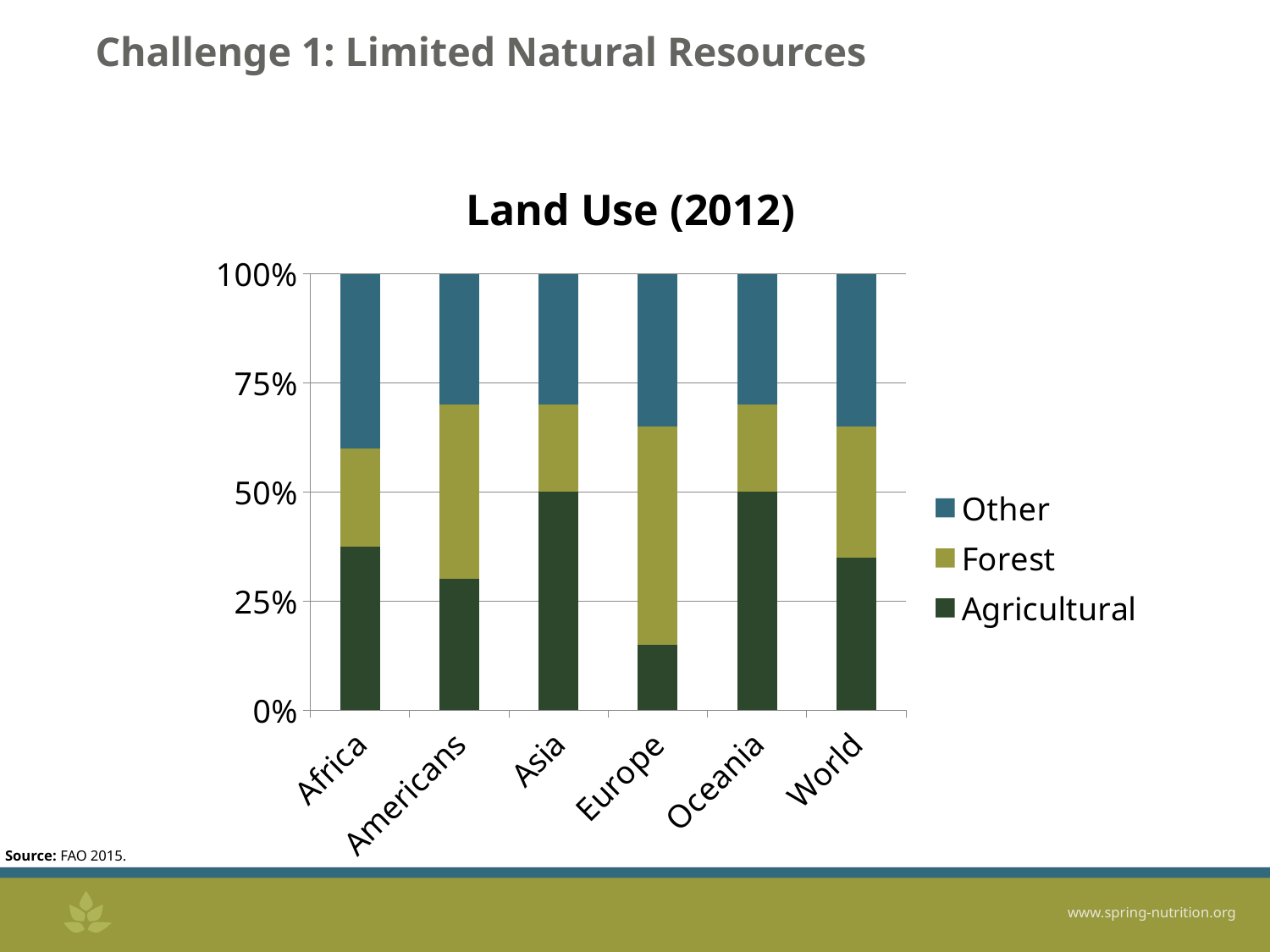
Which region has the largest Forest share of land use? Europe How many series does the legend list? 3 Which is larger, the Agricultural share for Asia or the Agricultural share for Europe? Asia What kind of chart is shown on the slide? Stacked bar chart What source is cited for the chart data? FAO 2015 What is the total height of the stacked bar for World? 100% What is the title of the chart? Land Use (2012) Is the Agricultural share for Europe greater or less than 25%? less Which region has the smallest Agricultural share of land use? Europe How many regions are shown on the x axis of the chart? 6 Is the Agricultural share for Americans greater or less than 50%? less Is the Agricultural share for Africa greater or less than 25%? greater